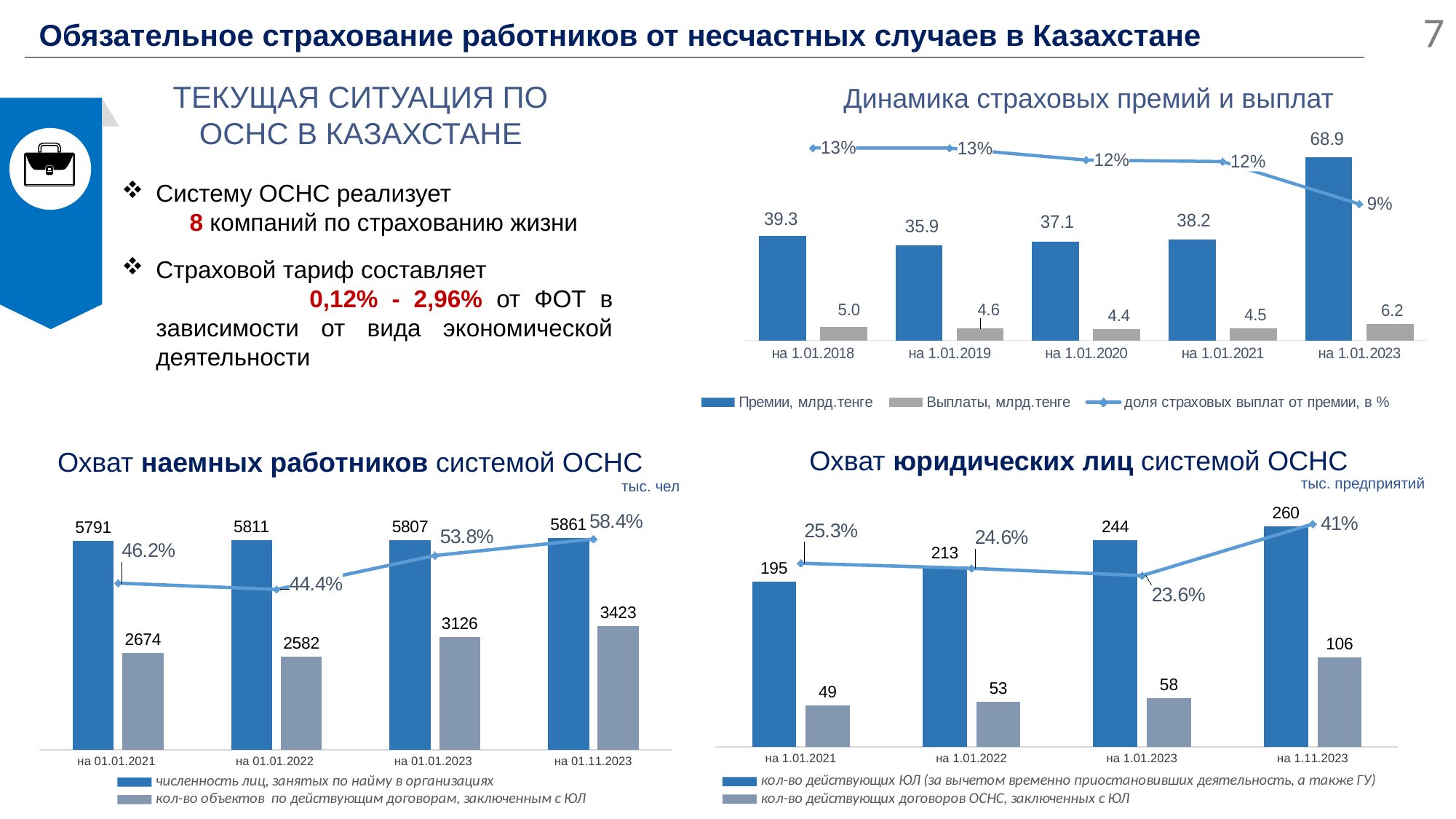
In the chart 'Охват юридических лиц системой ОСНС', what is the difference between the values of 'кол-во действующих ЮЛ' for 'на 1.01.2023' and 'на 1.01.2022'? 31 In the chart 'Охват наемных работников системой ОСНС', what is the value of 'кол-во объектов по действующим договорам, заключенным с ЮЛ' for 'на 01.01.2023'? 3126 In the chart 'Охват наемных работников системой ОСНС', does the line series rise or fall from 'на 01.01.2022' to 'на 01.11.2023'? rise How many series does the legend of the chart 'Динамика страховых премий и выплат' list? 3 In the chart 'Динамика страховых премий и выплат', what is the value of 'доля страховых выплат от премии, в %' for 'на 1.01.2023'? 9% In the chart 'Динамика страховых премий и выплат', what is the difference between 'Премии, млрд.тенге' for 'на 1.01.2023' and for 'на 1.01.2021'? 30.7 In the chart 'Динамика страховых премий и выплат', what is the value of 'Премии, млрд.тенге' for 'на 1.01.2023'? 68.9 In the chart 'Охват наемных работников системой ОСНС', which category has the highest value for 'численность лиц, занятых по найму в организациях'? на 01.11.2023 In the chart 'Охват юридических лиц системой ОСНС', what is the value of 'кол-во действующих договоров ОСНС, заключенных с ЮЛ' for 'на 1.11.2023'? 106 In the chart 'Динамика страховых премий и выплат', which category has the lowest value for 'Выплаты, млрд.тенге'? на 1.01.2020 In the chart 'Охват наемных работников системой ОСНС', how many categories are shown on the x axis? 4 What kind of chart is 'Охват юридических лиц системой ОСНС'? Combined bar and line chart